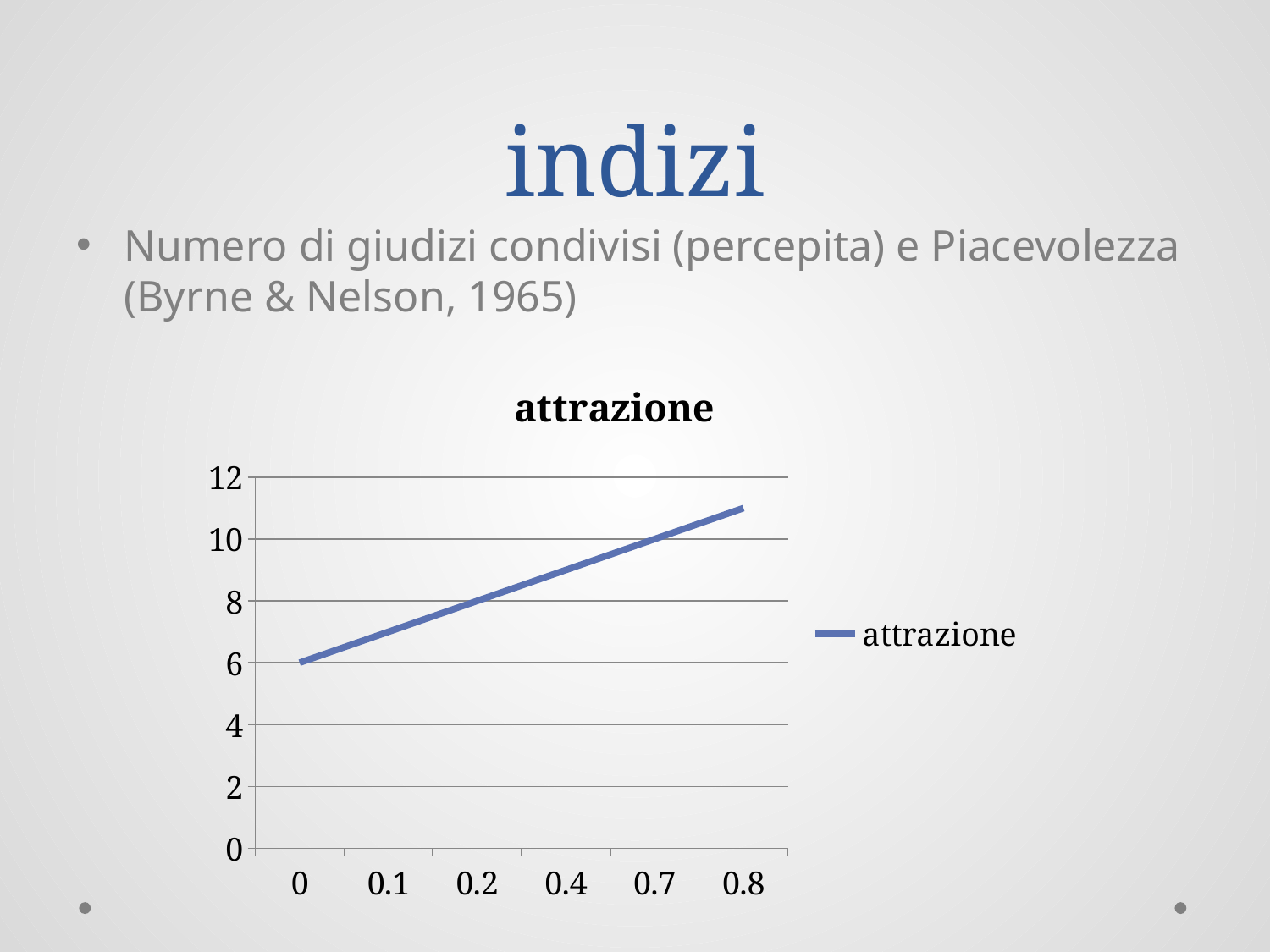
At which x value is attrazione lowest? 0 At which x value is attrazione highest? 0.8 Is the value for attrazione at x = 0.7 greater or less than 8? greater Do the values rise or fall along the x axis? rise How many points are plotted along the x axis? 6 Is the value for attrazione at x = 0.1 greater or less than 8? less What is the title of the chart? attrazione Is the value for attrazione at x = 0.8 greater or less than 10? greater What kind of chart is shown on the slide? line chart What is the value of attrazione at x = 0? 6 Which is larger, the value at x = 0.2 or the value at x = 0.7? 0.7 How many series does the legend list? 1